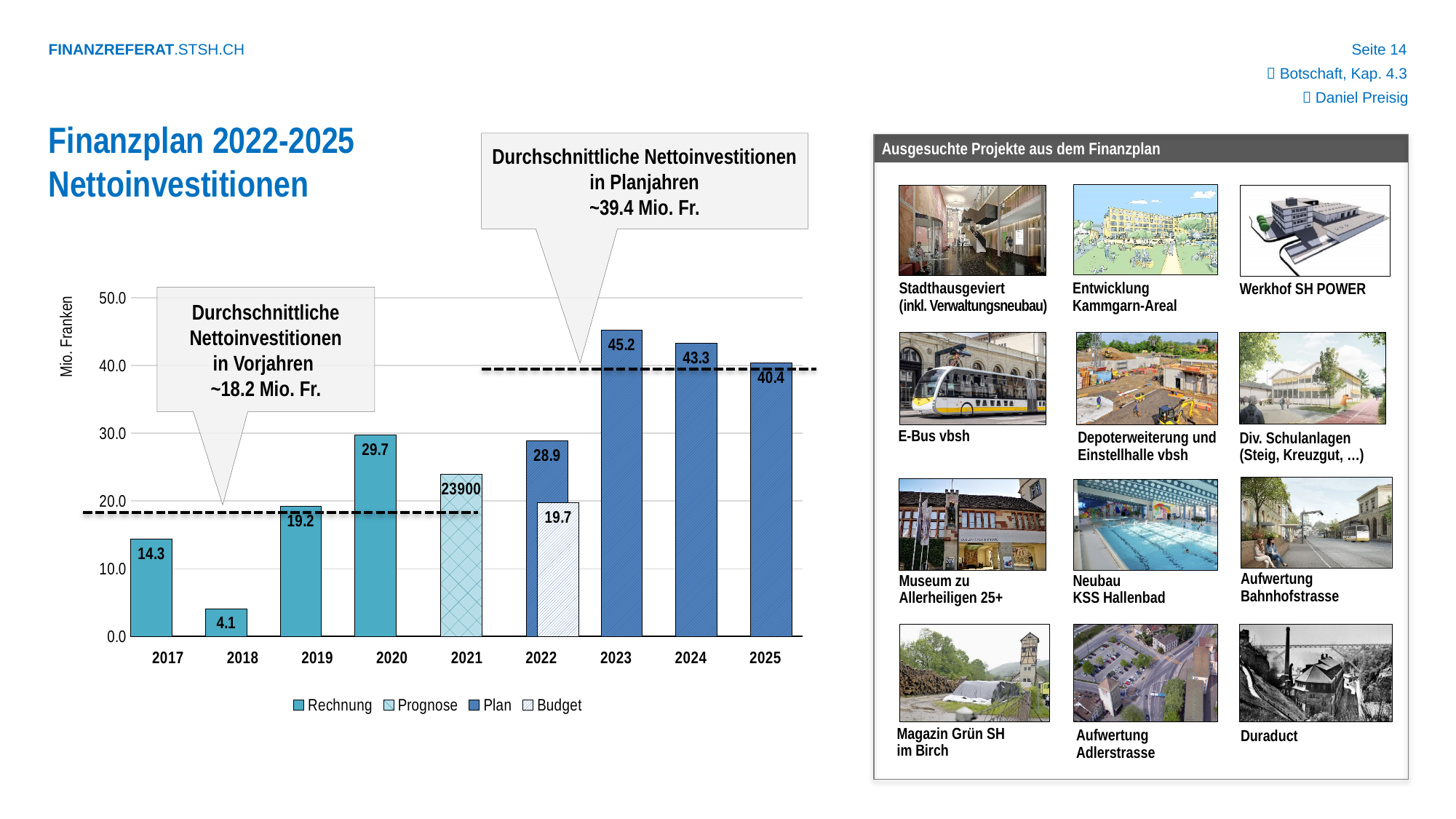
Is the value for 2021 greater or less than 20.0? greater Which year has the lowest net investment value in the chart? 2018 What unit is given on the y axis of the chart? Mio. Franken Which is larger: the value for 2020 or the Plan value for 2022? 2020 What is the value for 2023 in the Nettoinvestitionen chart? 45.2 What is the Budget value shown for 2022? 19.7 What is the difference between the values for 2023 and 2024? 1.9 Which year has the highest net investment value in the chart? 2023 How many years are shown on the x axis of the chart? 9 What is the value for 2017 in the Nettoinvestitionen chart? 14.3 How many series does the chart legend list? 4 What kind of chart is shown on the slide? bar chart